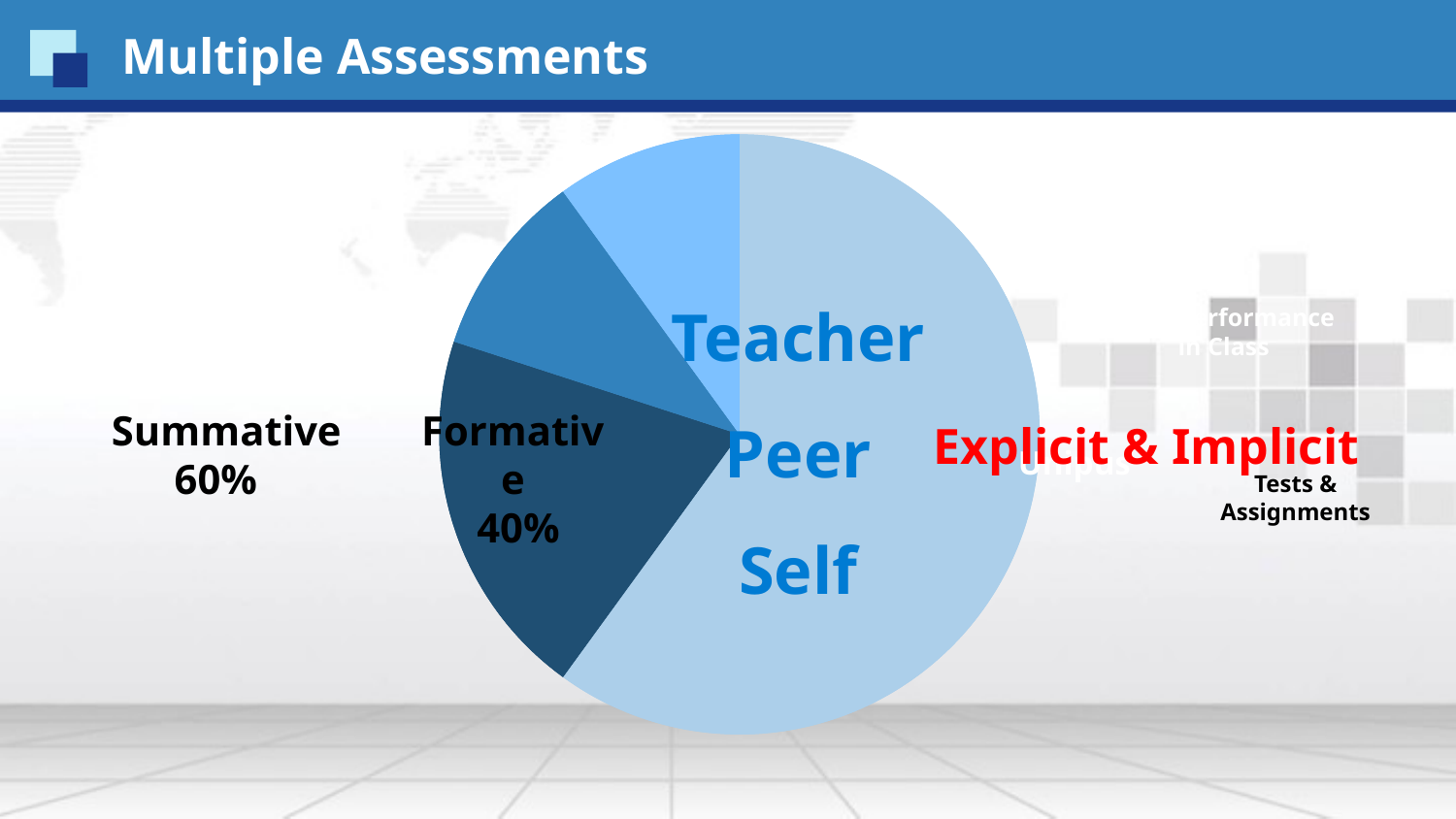
What three words are printed in blue inside the pie chart? Teacher, Peer, Self What percentage is shown for Summative assessment? 60% What percentage is shown for Formative assessment? 40% What is the title of the slide containing the pie chart? Multiple Assessments Is the Formative share greater or less than 50%? less How many slices does the pie chart have? 4 Is the Summative share greater or less than 50%? greater What do the Summative and Formative percentages add up to? 100% What kind of chart is shown on the slide? pie chart Which has the larger share, Summative or Formative? Summative What is the difference between the Summative and Formative percentages? 20%